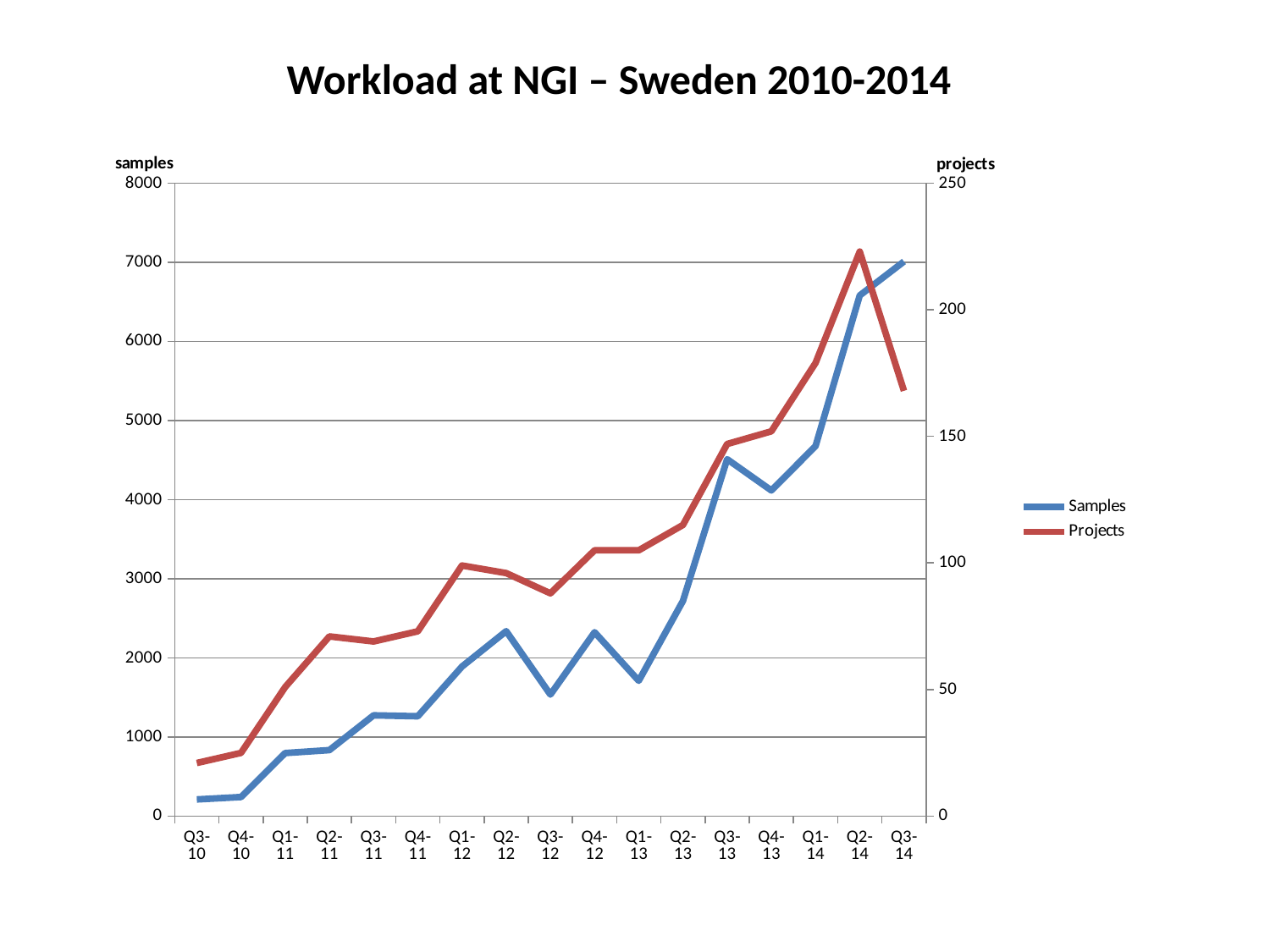
Which quarter has the highest value for Samples? Q3-14 Is the value for Projects at Q3-10 greater or less than 50? less Which is larger for Samples: the value at Q2-12 or the value at Q3-12? Q2-12 What kind of chart is shown on the slide? line chart How many series does the legend list? 2 Is the value for Samples at Q3-10 greater or less than 1000? less Is the value for Samples at Q2-14 greater or less than 6000? greater Which quarter has the highest value for Projects? Q2-14 What is the label on the right-hand vertical axis? projects How many quarters are plotted along the x axis? 17 Do the Projects values rise or fall from Q2-14 to Q3-14? fall